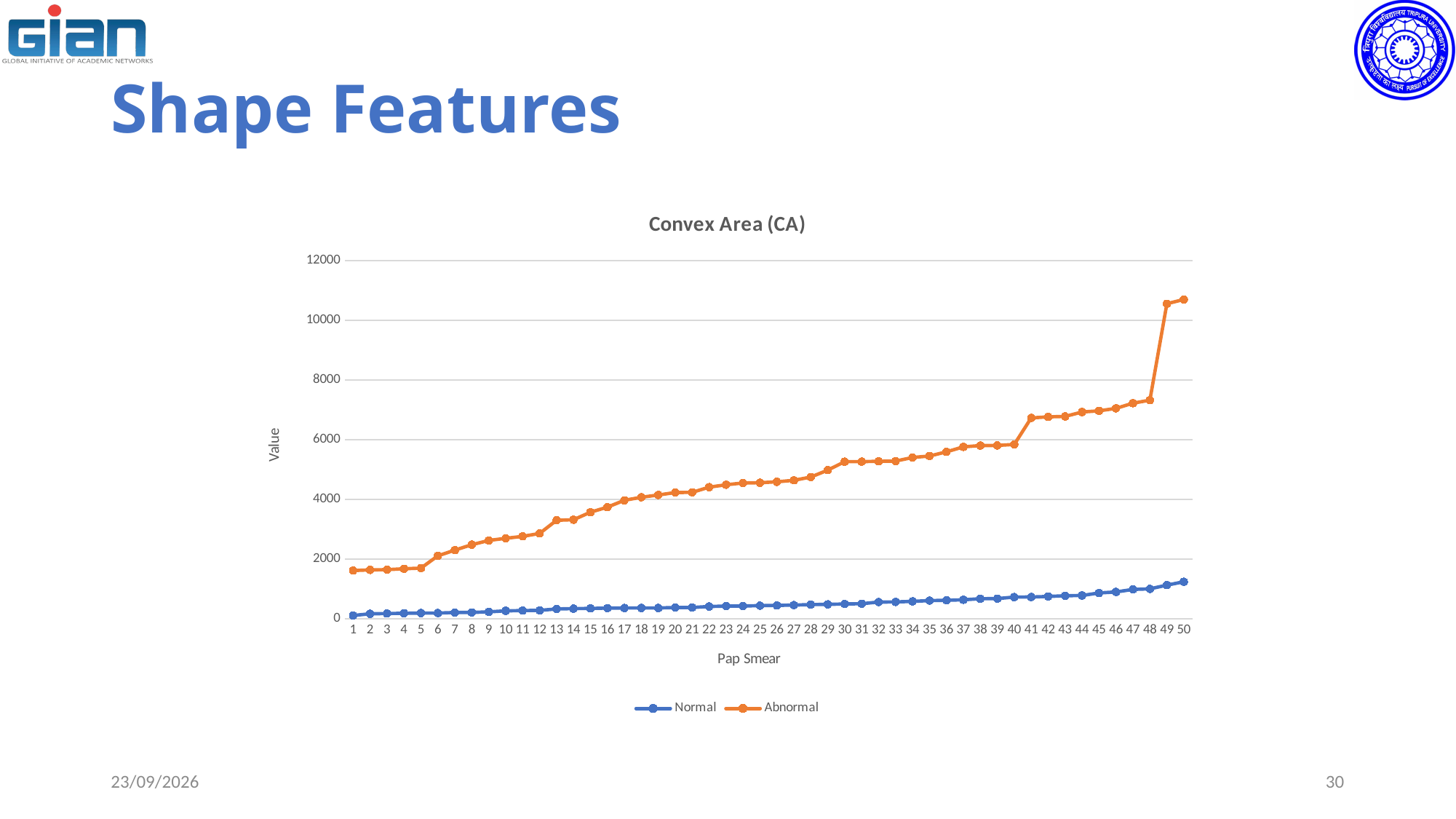
What is the label of the x axis? Pap Smear What is the title of the chart? Convex Area (CA) Which series has the larger value at Pap Smear 25, Normal or Abnormal? Abnormal Is the Abnormal value at Pap Smear 50 greater or less than 10000? greater How many series does the legend list? 2 Do the Abnormal values rise or fall as the Pap Smear number increases from 1 to 50? rise How many Pap Smear points are plotted along the x axis for each series? 50 Is the Normal value at Pap Smear 50 greater or less than 2000? less What kind of chart is shown on the slide? line chart At which Pap Smear number does the Abnormal series reach its highest value? 50 Is the Abnormal value at Pap Smear 1 greater or less than 2000? less